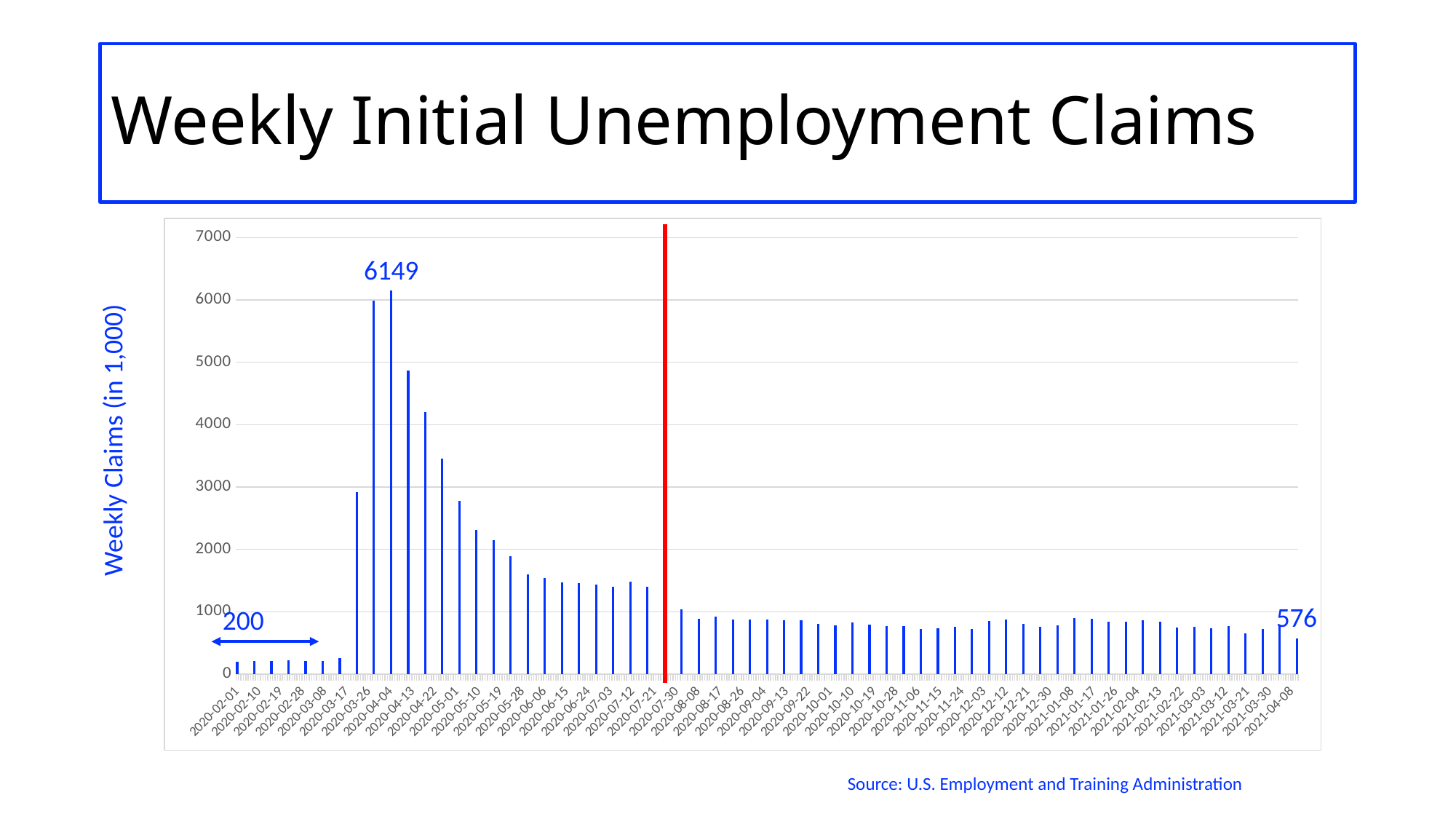
Do the values rise or fall from the peak in April 2020 to the end of the chart? fall What value is labelled for the last bar (2021-04-08)? 576 What kind of chart is shown on the slide? Bar chart What value is annotated for the early weeks at the start of the chart? 200 What is the difference between the peak value of 6149 and the final value of 576? 5573 What colour is the vertical line drawn at 2020-07-30? Red Is the value for the last bar (2021-04-08) greater or less than 1000? less Is the peak value on the chart greater or less than 6000? greater What is the title of the y axis? Weekly Claims (in 1,000) What is the title of the chart? Weekly Initial Unemployment Claims Which is larger, the peak value labelled 6149 or the final value labelled 576? 6149 What is the highest value labelled on the chart? 6149